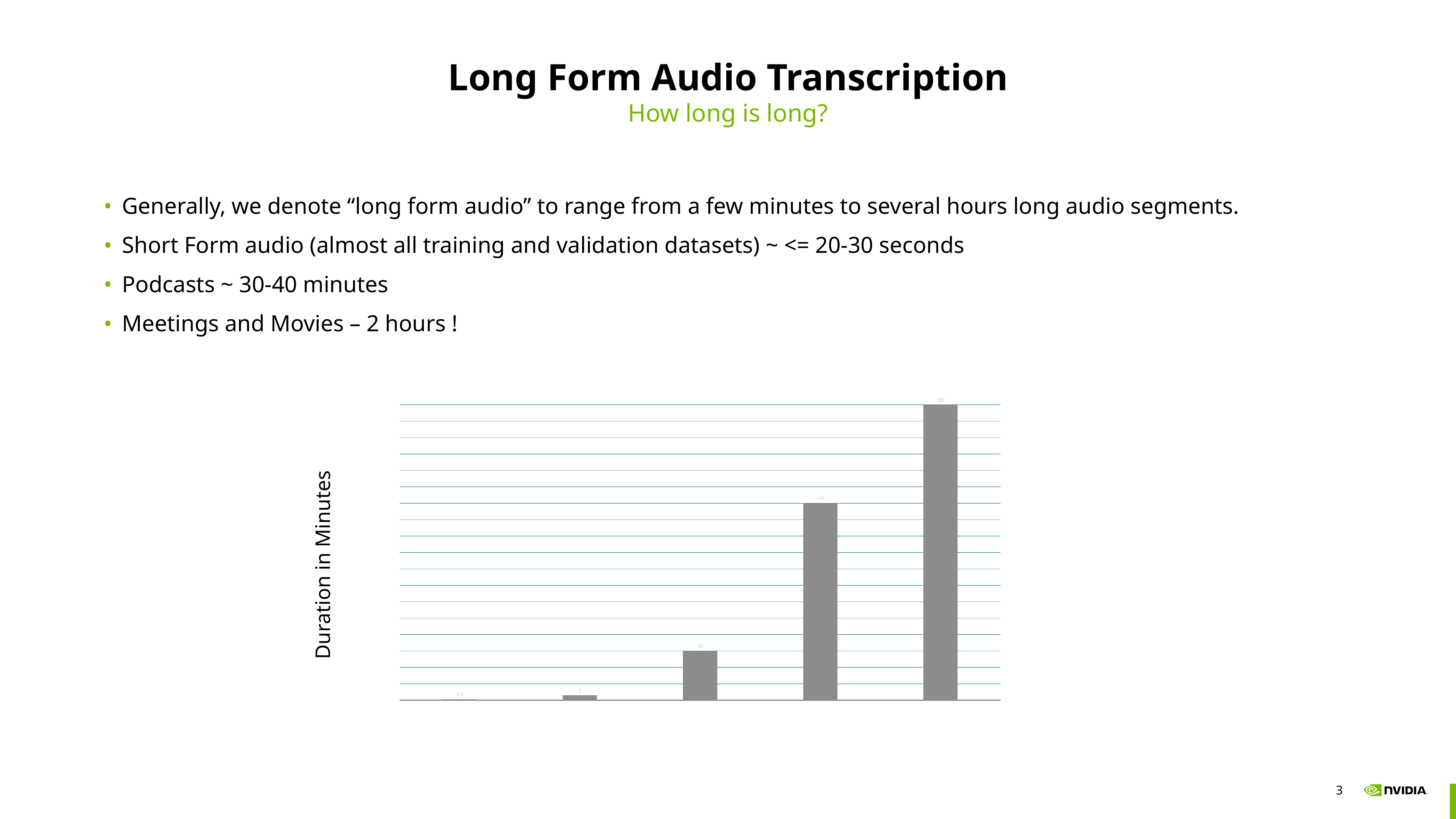
What is the value labelled on the third bar from the left? 30 What kind of chart is shown on the slide? bar chart What is the difference between the values of the third and second bars from the left? 27 How many bars does the chart show? 5 What is the title of the chart's vertical axis? Duration in Minutes Which is larger, the fourth bar from the left or the third bar from the left? the fourth bar What is the value labelled on the shortest bar in the chart? 0.5 What is the difference between the values of the rightmost bar and the fourth bar from the left? 60 What is the value labelled on the second bar from the left? 3 Do the bar values rise or fall from left to right across the chart? rise What is the value labelled on the fourth bar from the left? 120 What is the value labelled on the tallest bar in the chart? 180